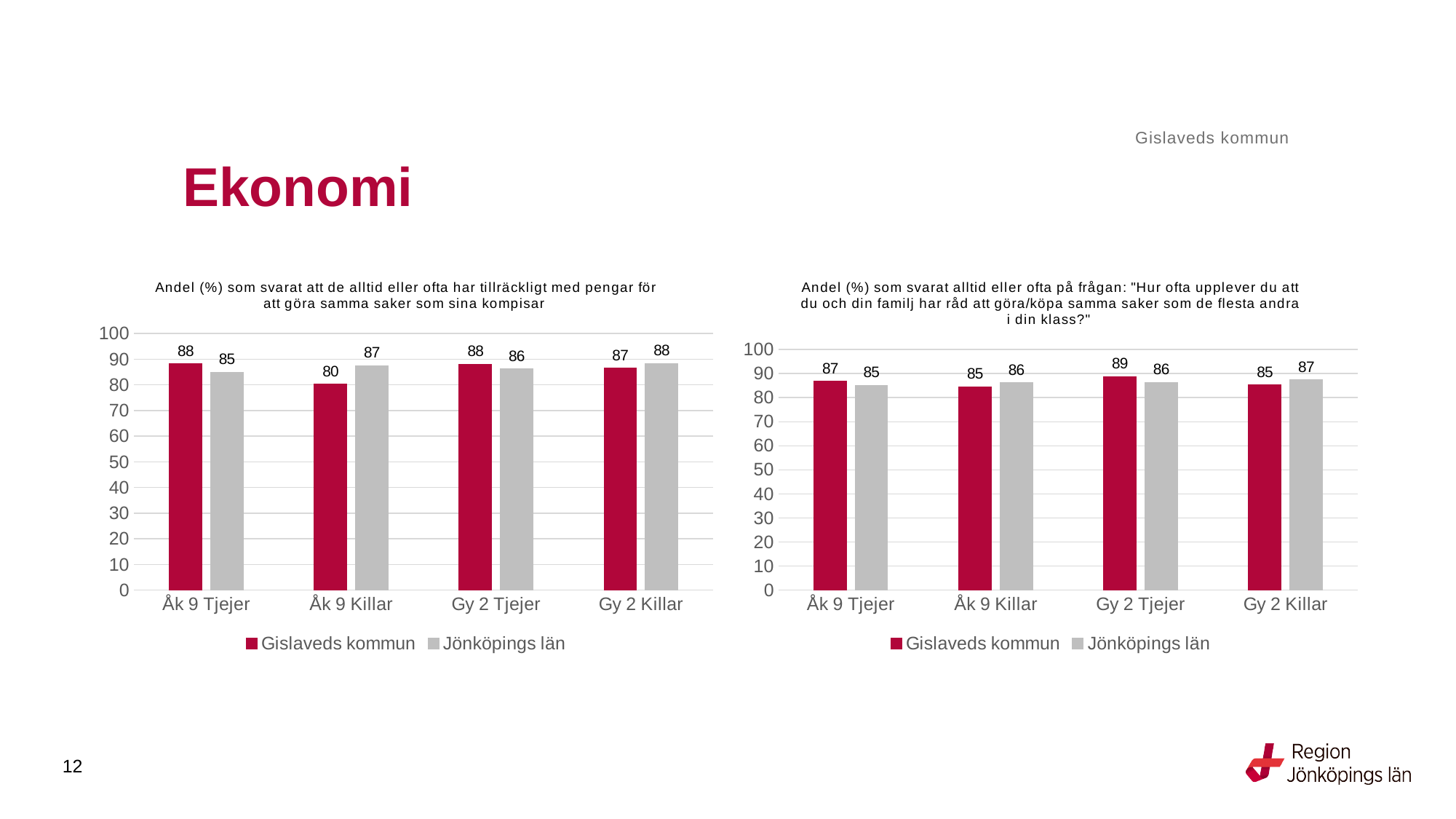
In the right chart, what is the difference between Gislaveds kommun and Jönköpings län for Gy 2 Tjejer? 3 In the left chart, what is the difference between Jönköpings län and Gislaveds kommun for Åk 9 Killar? 7 In the left chart, what is the value for Gislaveds kommun for Åk 9 Killar? 80 In the left chart, which category has the lowest value for Gislaveds kommun? Åk 9 Killar In the right chart, what is the value for Gislaveds kommun for Gy 2 Tjejer? 89 In the right chart, what is the value for Jönköpings län for Åk 9 Tjejer? 85 In the right chart, which category has the highest value for Gislaveds kommun? Gy 2 Tjejer What kind of chart is the left chart? Bar chart How many categories are shown on the x axis of the left chart? 4 How many series does the legend of the right chart list? 2 In the left chart, what is the value for Jönköpings län for Gy 2 Killar? 88 In the left chart, which is larger for Åk 9 Tjejer: Gislaveds kommun or Jönköpings län? Gislaveds kommun